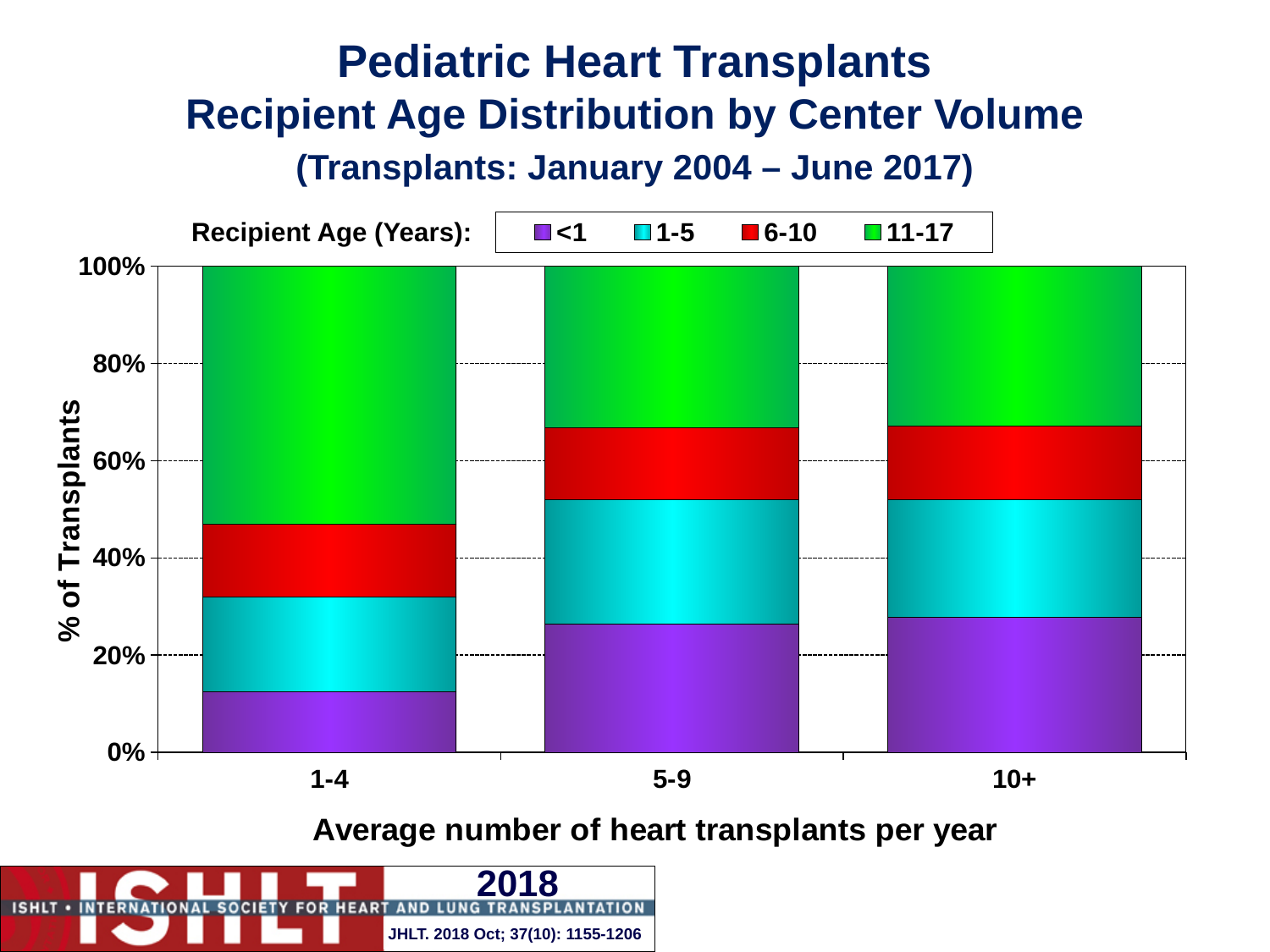
What kind of chart is shown on the slide? Stacked bar chart Which center volume category has the largest share of recipients aged 11-17? 1-4 Is the share of recipients aged 11-17 at centers with 1-4 transplants per year greater or less than 40%? greater How many recipient age groups does the legend list? 4 Which colour represents recipients aged 6-10 in the legend? Red Is the share of recipients aged <1 at centers with 1-4 transplants per year greater or less than 20%? less Which center volume category has the smallest share of recipients aged <1? 1-4 Does the share of recipients aged <1 rise or fall from the 1-4 category to the 10+ category? rise How many center volume categories are shown on the x axis? 3 What is the label of the x axis? Average number of heart transplants per year Which has a larger share of recipients aged 11-17: centers with 1-4 transplants per year or centers with 5-9 transplants per year? 1-4 Is the share of recipients aged <1 at centers with 5-9 transplants per year greater or less than 20%? greater